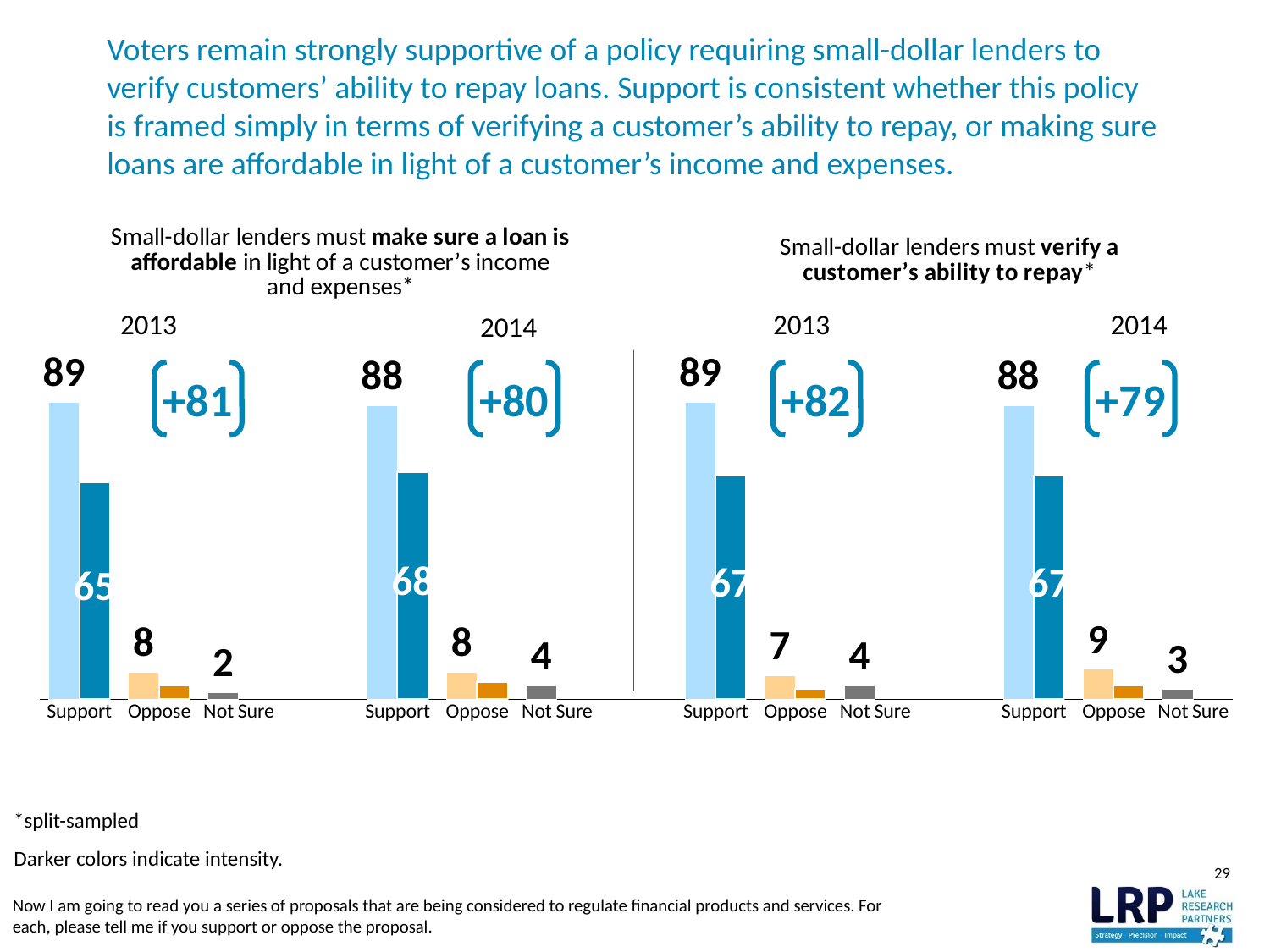
In the 2013 chart for 'Small-dollar lenders must verify a customer's ability to repay', what is the value for Oppose? 7 In the 2013 chart for 'Small-dollar lenders must make sure a loan is affordable in light of a customer's income and expenses', what is the value for Support? 89 How many categories are shown on the x axis of the 2014 chart for 'Small-dollar lenders must make sure a loan is affordable in light of a customer's income and expenses'? 3 In the 2014 chart for 'Small-dollar lenders must verify a customer's ability to repay', what is the value for Oppose? 9 In the 2013 chart for 'Small-dollar lenders must make sure a loan is affordable in light of a customer's income and expenses', what is the difference between Support and Oppose? 81 In the 2013 chart for 'Small-dollar lenders must verify a customer's ability to repay', which is larger, Oppose or Not Sure? Oppose What net support figure is shown in brackets on the 2014 chart for 'Small-dollar lenders must verify a customer's ability to repay'? +79 What kind of chart is used for the 2013 'Small-dollar lenders must verify a customer's ability to repay' data? Bar chart In the 2013 chart for 'Small-dollar lenders must make sure a loan is affordable in light of a customer's income and expenses', which category has the lowest value? Not Sure In the 2014 chart for 'Small-dollar lenders must verify a customer's ability to repay', what is the difference between Oppose and Not Sure? 6 In the 2014 chart for 'Small-dollar lenders must verify a customer's ability to repay', which category has the highest value? Support In the 2014 chart for 'Small-dollar lenders must make sure a loan is affordable in light of a customer's income and expenses', what is the value for Not Sure? 4